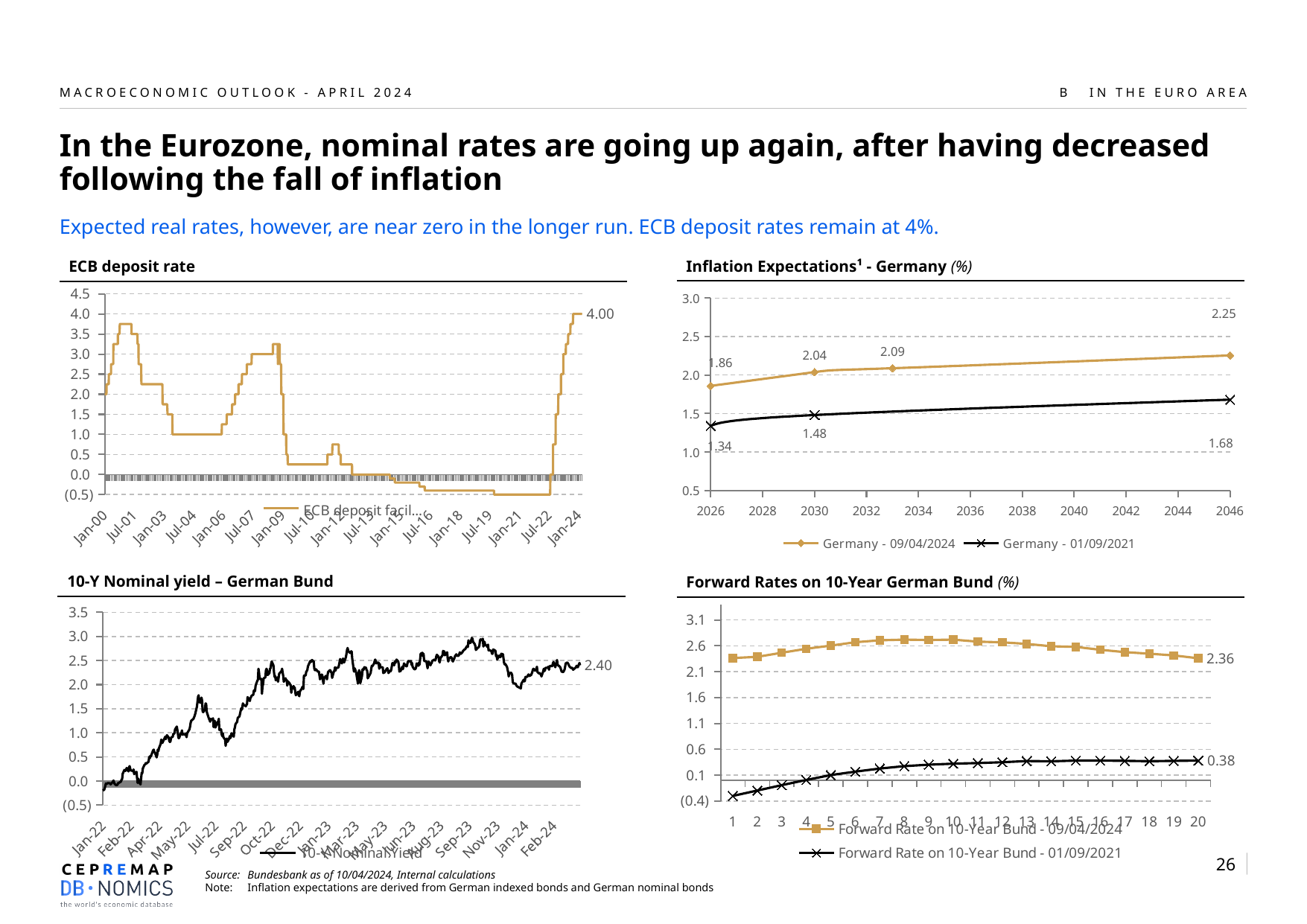
On the Inflation Expectations - Germany chart, what is the difference between the two series' values in 2046? 0.57 On the Forward Rates on 10-Year German Bund chart, how many series does the legend list? 2 On the Inflation Expectations - Germany chart, what is the value of the Germany - 01/09/2021 series in 2030? 1.48 On the ECB deposit rate chart, what is the latest value labelled at the end of the line? 4.00 On the Inflation Expectations - Germany chart, which series is higher across the whole period? Germany - 09/04/2024 What kind of chart is the ECB deposit rate chart? line chart On the Forward Rates on 10-Year German Bund chart, what is the difference between the labelled end values of the 09/04/2024 and 01/09/2021 series? 1.98 On the Inflation Expectations - Germany chart, what is the value of the Germany - 09/04/2024 series in 2026? 1.86 On the Forward Rates on 10-Year German Bund chart, is the value of the 09/04/2024 series at year 1 greater or less than 2.1? greater On the Inflation Expectations - Germany chart, does the Germany - 09/04/2024 series rise or fall from 2026 to 2046? rise On the 10-Y Nominal yield – German Bund chart, what is the value labelled at the end of the line? 2.40 On the Forward Rates on 10-Year German Bund chart, how many points are on the x axis? 20